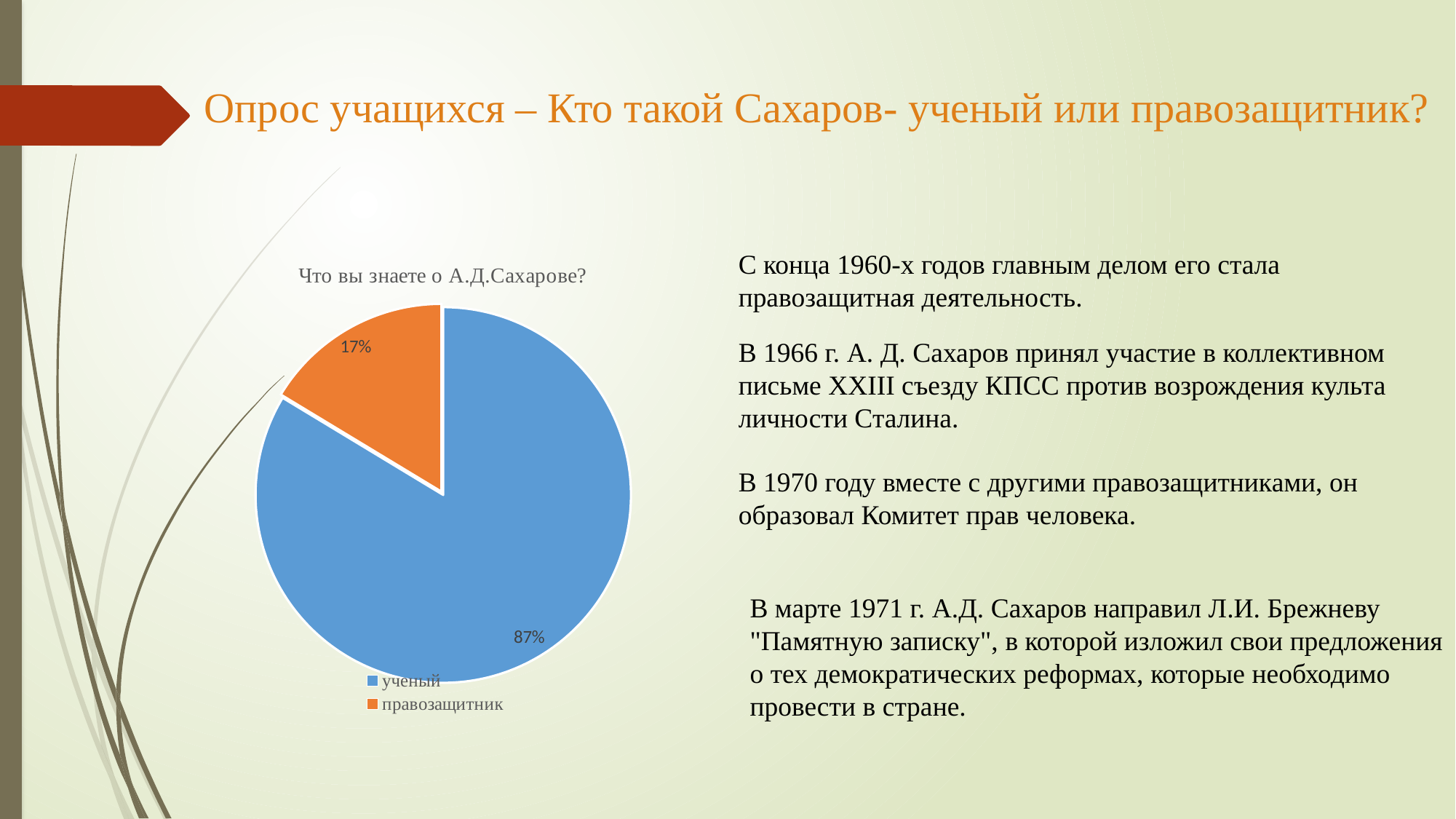
How many entries does the legend list? 2 What kind of chart is shown on the slide? pie chart What percentage of the pie is labelled for "ученый"? 87% What is the title of the chart? Что вы знаете о А.Д.Сахарове? What is the difference between the labelled shares for "ученый" and "правозащитник"? 70% What percentage of the pie is labelled for "правозащитник"? 17% How many categories does the pie chart show? 2 Which category has the smallest share of the pie? правозащитник Which is larger, the share for "ученый" or the share for "правозащитник"? ученый Which category has the largest share of the pie? ученый What colour is the slice for "правозащитник"? orange